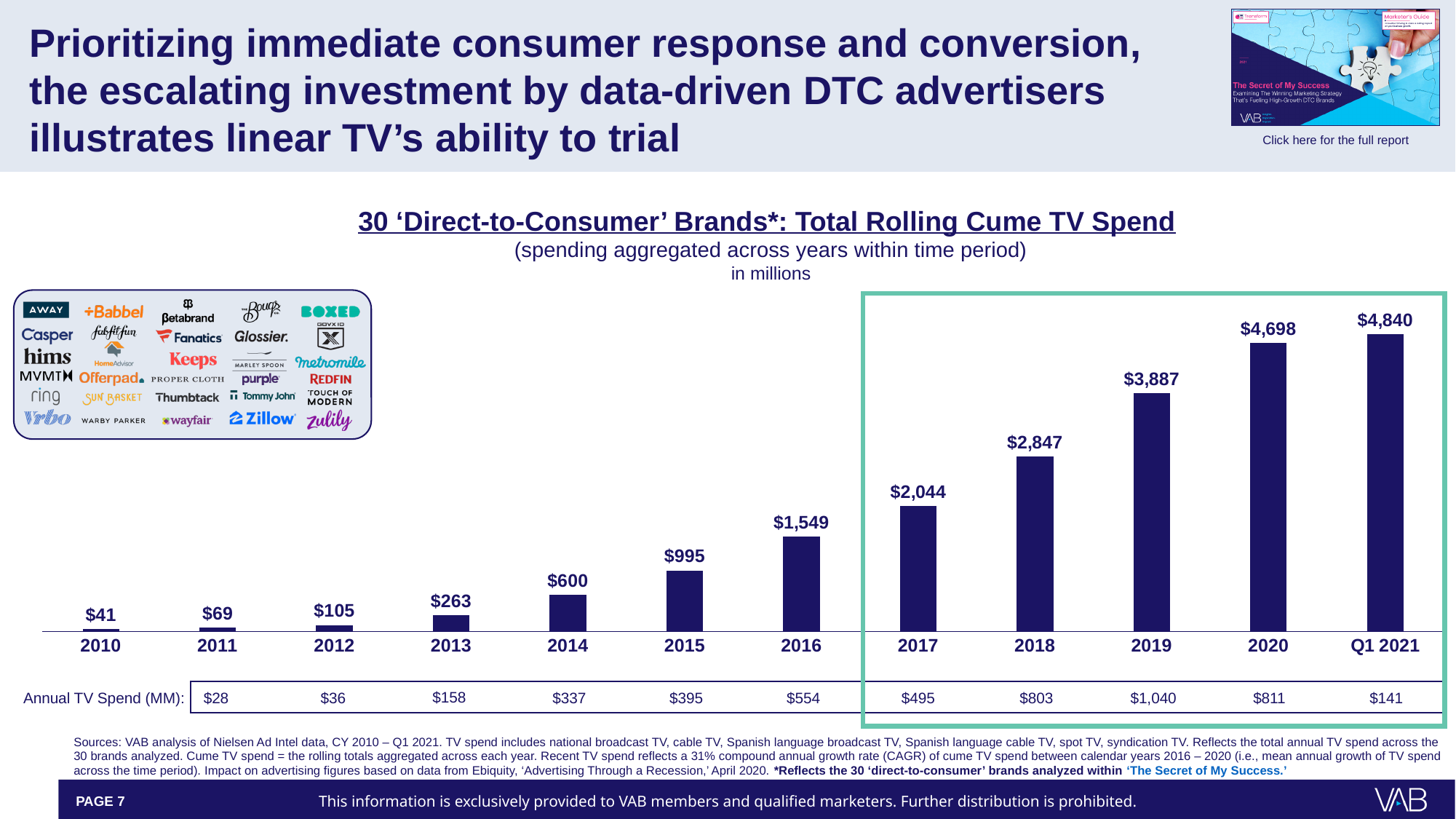
How many periods are shown on the x axis of the chart? 12 What kind of chart is used to show the total rolling cume TV spend? Bar chart What is the total rolling cume TV spend for 2013? $263 What is the total rolling cume TV spend for Q1 2021? $4,840 What is the total rolling cume TV spend for 2016? $1,549 What is the annual TV spend (MM) shown below the chart for 2019? $1,040 Which is larger, the cume TV spend in 2015 or in 2014? 2015 Do the cume TV spend values rise or fall from 2010 to Q1 2021? Rise What is the difference between the cume TV spend in 2018 and in 2017? $803 Which period has the lowest total rolling cume TV spend? 2010 Which period has the highest total rolling cume TV spend? Q1 2021 What is the difference between the cume TV spend in 2020 and in 2019? $811